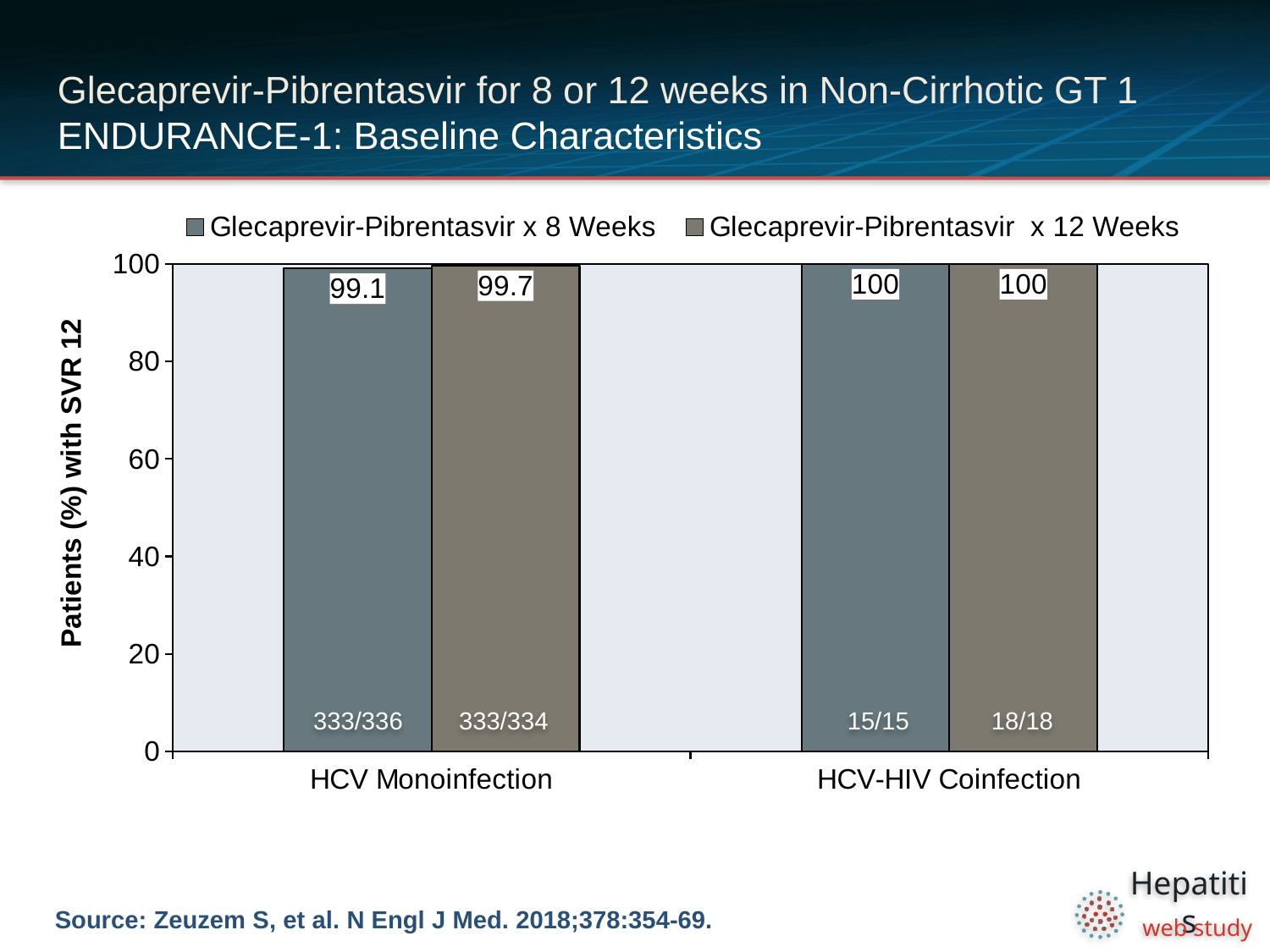
What fraction of patients is shown for Glecaprevir-Pibrentasvir x 12 Weeks in the HCV-HIV Coinfection group? 18/18 Which bar has the lowest SVR 12 rate on the chart? Glecaprevir-Pibrentasvir x 8 Weeks, HCV Monoinfection What is the difference in SVR 12 rate between the 12-week and 8-week arms in the HCV Monoinfection group? 0.6 What is the SVR 12 rate for Glecaprevir-Pibrentasvir x 8 Weeks in the HCV-HIV Coinfection group? 100 What is the label of the y axis? Patients (%) with SVR 12 What fraction of patients is shown for Glecaprevir-Pibrentasvir x 8 Weeks in the HCV Monoinfection group? 333/336 How many patient groups are shown on the x axis? 2 What type of chart is shown on the slide? Bar chart What is the SVR 12 rate for Glecaprevir-Pibrentasvir x 12 Weeks in the HCV Monoinfection group? 99.7 In the HCV Monoinfection group, which arm has the higher SVR 12 rate, 8 weeks or 12 weeks? Glecaprevir-Pibrentasvir x 12 Weeks What is the SVR 12 rate for Glecaprevir-Pibrentasvir x 8 Weeks in the HCV Monoinfection group? 99.1 How many series does the legend list? 2